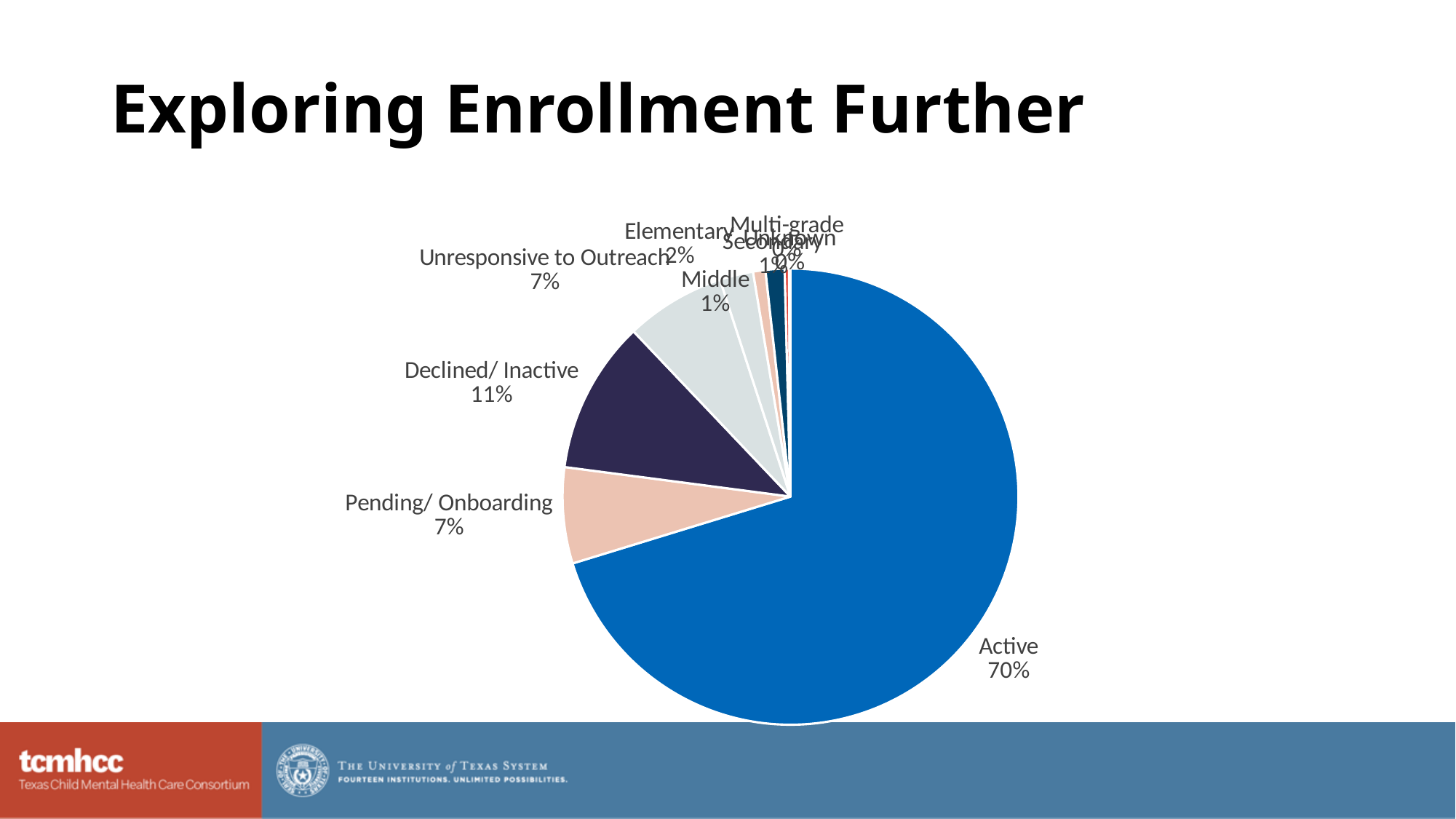
What kind of chart is shown on the slide? pie chart What percentage is shown for Middle? 1% What percentage is shown for Declined/ Inactive? 11% What percentage is shown for Unresponsive to Outreach? 7% What percentage is shown for Elementary? 2% Which is larger, Declined/ Inactive or Pending/ Onboarding? Declined/ Inactive What percentage is shown for Pending/ Onboarding? 7% Which slice of the pie is the largest? Active How many percentage points larger is Active than Declined/ Inactive? 59 percentage points What is the title of the slide containing the pie chart? Exploring Enrollment Further What share of the pie does the Active slice represent? 70% Which is larger, Elementary or Middle? Elementary